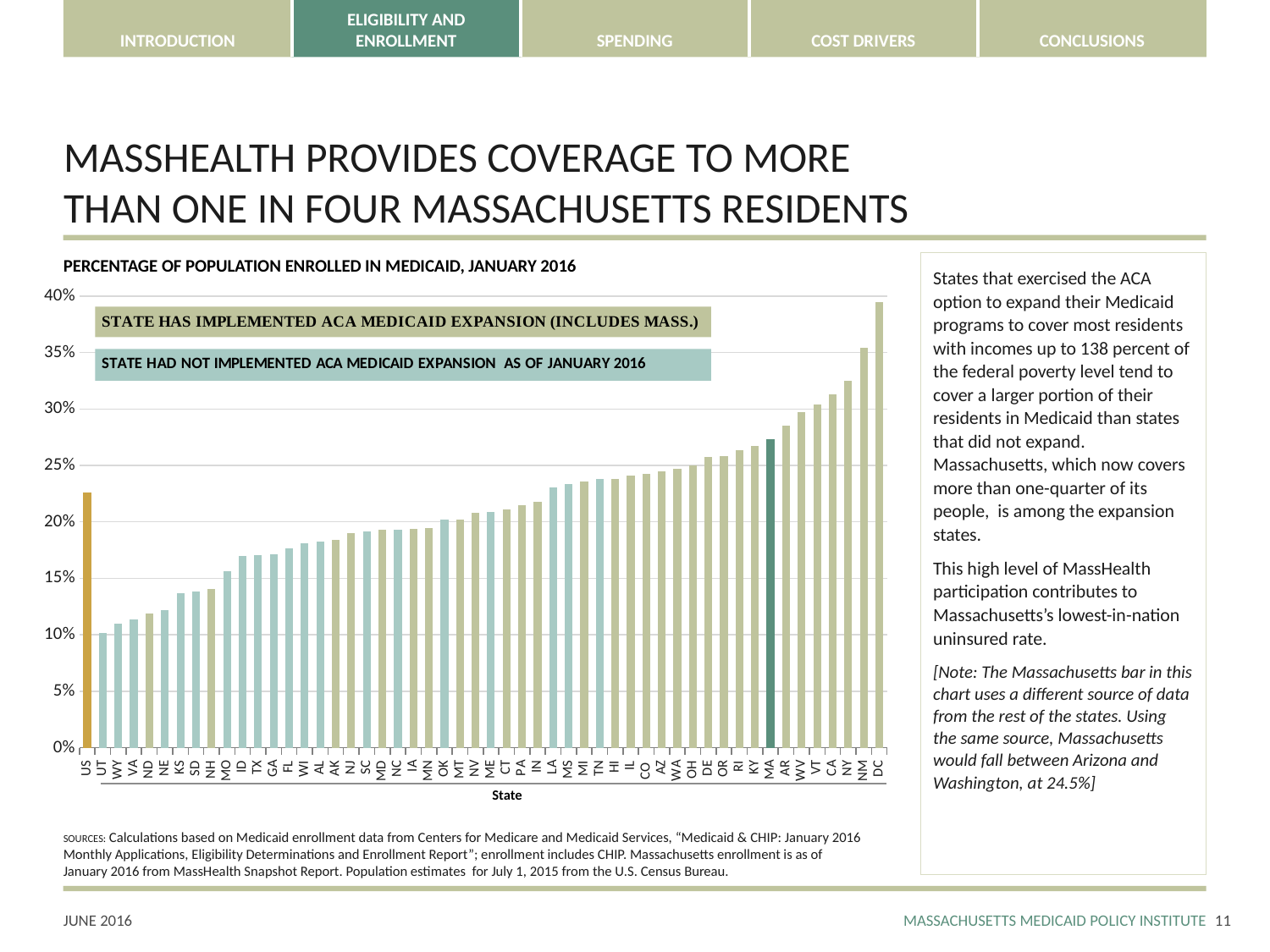
Is the value for UT greater or less than 15%? less Which state has the lowest percentage of population enrolled in Medicaid? UT Which state has the highest percentage of population enrolled in Medicaid? DC Is the value for MA greater or less than 25%? greater Is the value for DC greater or less than 35%? greater Do the bar values generally rise or fall moving from left to right along the x axis? rise What kind of chart is shown on the slide? bar chart Which has a higher percentage of population enrolled in Medicaid, NY or VA? NY How many bars are plotted in the chart? 52 What is the title of the chart? Percentage of Population Enrolled in Medicaid, January 2016